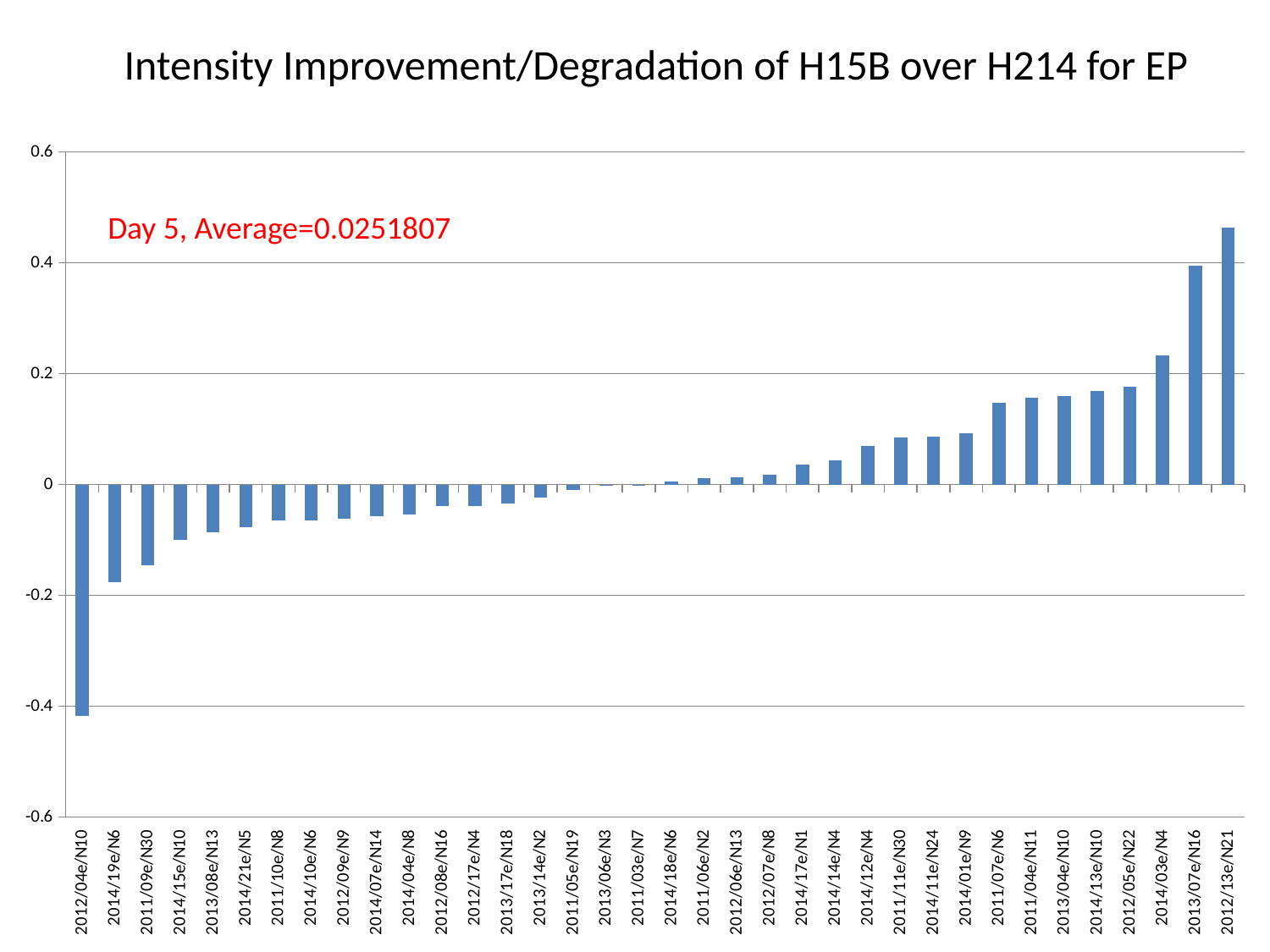
How many categories are plotted along the x axis? 36 Which category has the highest value? 2012/13e/N21 Is the value for 2014/03e/N4 greater or less than 0.2? greater Is the value for 2012/13e/N21 greater or less than 0.4? greater Do the values rise or fall moving from left to right along the x axis? rise Which category has the lowest value? 2012/04e/N10 What is the title of the chart? Intensity Improvement/Degradation of H15B over H214 for EP Is the value for 2011/09e/N30 greater or less than -0.2? greater Which has the larger value, 2014/03e/N4 or 2014/12e/N4? 2014/03e/N4 What average value is printed in the red annotation on the chart? 0.0251807 What kind of chart is shown on the slide? bar chart